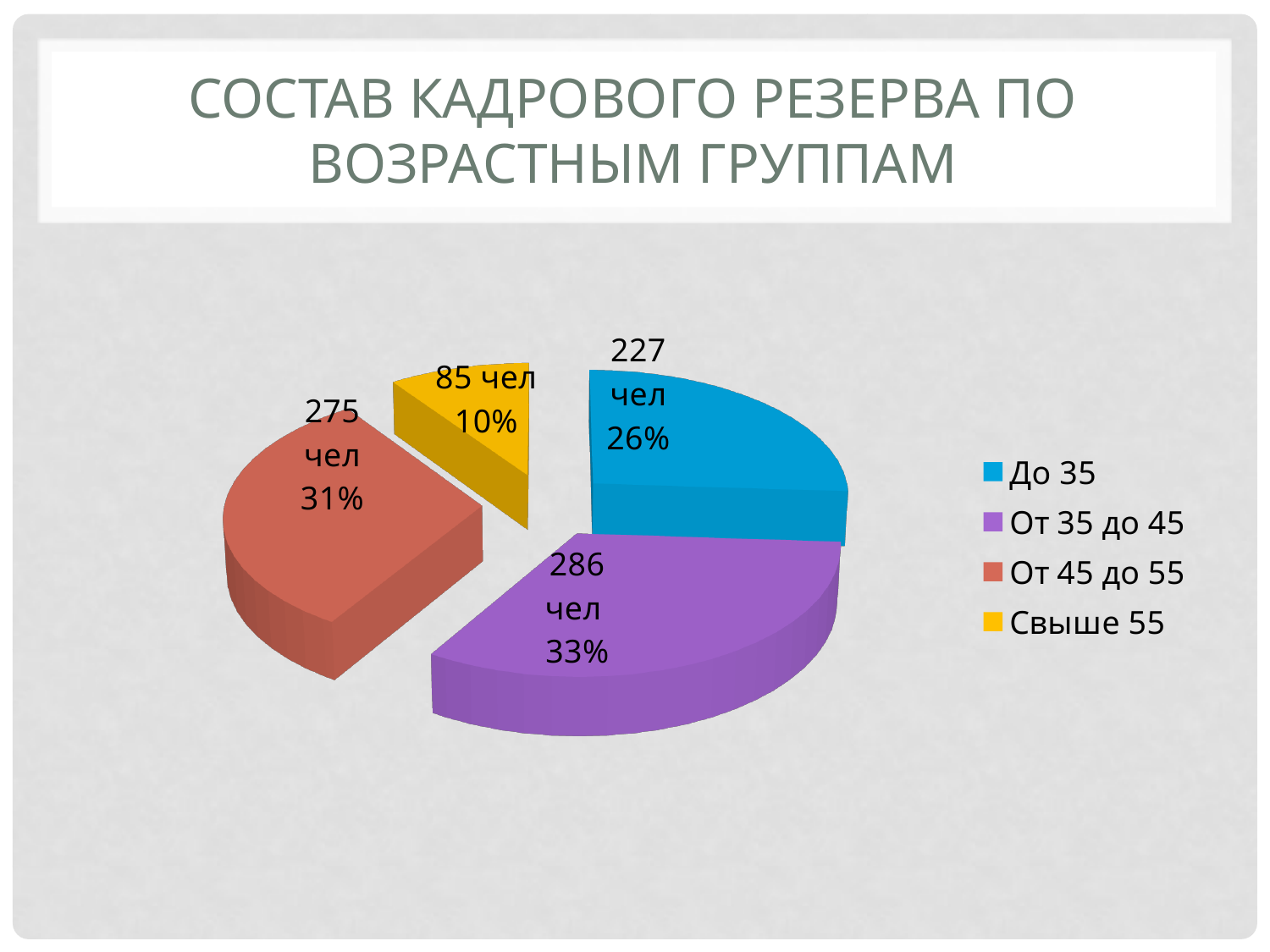
What colour is the slice for the "Свыше 55" group? yellow Which age group has the smallest number of people? Свыше 55 How many people are in the "От 45 до 55" age group? 275 чел What is the difference in people between the "От 35 до 45" group and the "До 35" group? 59 What kind of chart is shown on the slide? pie chart Which age group has the largest number of people? От 35 до 45 How many age groups are shown in the pie chart? 4 Which group has more people, "До 35" or "От 45 до 55"? От 45 до 55 What is the difference in people between the "От 45 до 55" group and the "Свыше 55" group? 190 What share of the pie does the "От 35 до 45" group represent? 33% How many people are in the "До 35" age group? 227 чел What share of the pie does the "Свыше 55" group represent? 10%